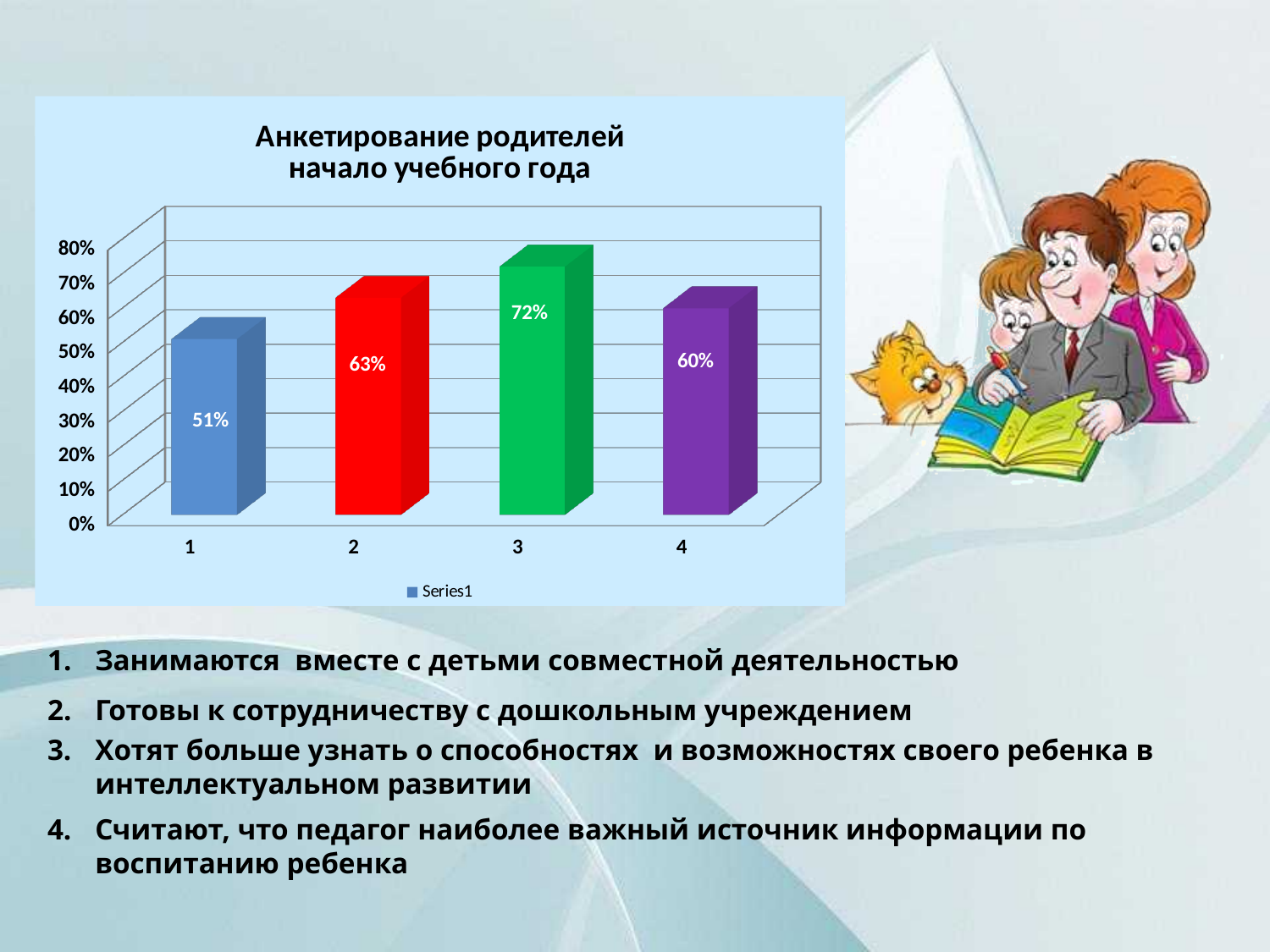
What is the value for category 1? 51% What is the title of the chart? Анкетирование родителей начало учебного года What is the value for category 3? 72% What is the difference between the values for category 2 and category 4? 3% Which category has the lowest value? 1 What is the value for category 4? 60% How many categories are shown on the x axis? 4 Which category has the highest value? 3 What kind of chart is shown on the slide? bar chart How many series does the legend list? 1 What is the difference between the values for category 3 and category 1? 21% Which is larger, the value for category 2 or the value for category 4? category 2